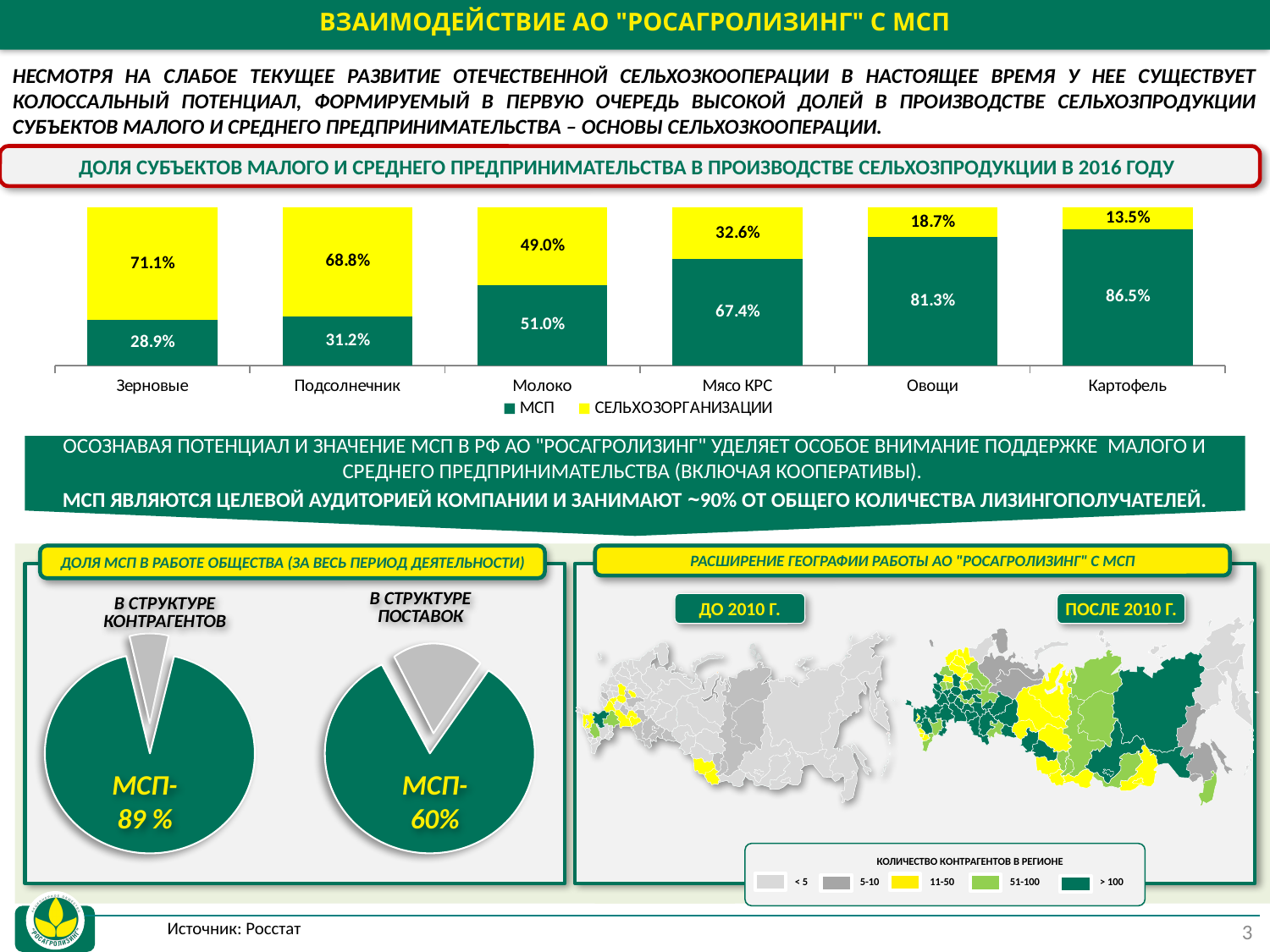
How many series does the legend of the stacked bar chart list? 2 In the pie chart 'В СТРУКТУРЕ КОНТРАГЕНТОВ', what share does МСП hold? 89 % In the stacked bar chart 'ДОЛЯ СУБЪЕКТОВ МАЛОГО И СРЕДНЕГО ПРЕДПРИНИМАТЕЛЬСТВА В ПРОИЗВОДСТВЕ СЕЛЬХОЗПРОДУКЦИИ В 2016 ГОДУ', what is the МСП value for Молоко? 51.0% In the stacked bar chart, do the МСП values rise or fall from Зерновые to Картофель along the x axis? Rise In the stacked bar chart, what is the СЕЛЬХОЗОРГАНИЗАЦИИ value for Зерновые? 71.1% In the stacked bar chart, what is the difference between the МСП values for Овощи and Мясо КРС? 13.9% In the stacked bar chart, which is larger: the СЕЛЬХОЗОРГАНИЗАЦИИ value for Подсолнечник or for Молоко? Подсолнечник In the pie chart 'В СТРУКТУРЕ ПОСТАВОК', what share does МСП hold? 60% In the stacked bar chart, which category has the highest МСП value? Картофель How many categories are shown on the x axis of the stacked bar chart? 6 In the stacked bar chart, which category has the lowest МСП value? Зерновые What kind of chart is used to show the share of МСП in agricultural production in 2016? Stacked bar chart